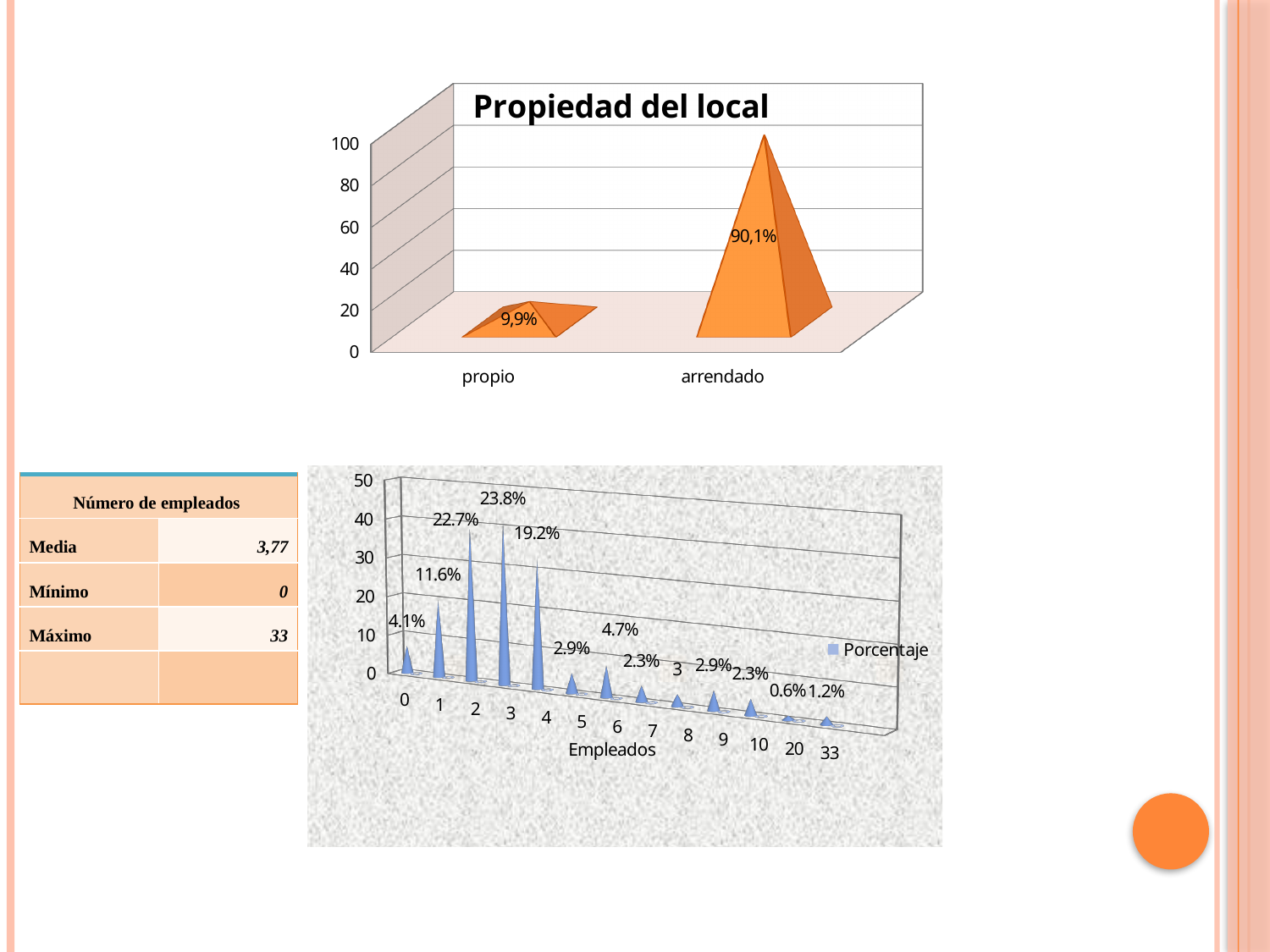
In the 'Propiedad del local' chart, what is the value for 'propio'? 9,9% In the bottom chart (Empleados), what is the value for 0 employees? 4.1% In the 'Propiedad del local' chart, how many categories are shown on the x axis? 2 In the bottom chart (Empleados), which number of employees has the lowest percentage? 20 In the bottom chart (Empleados), how many categories are shown on the x axis? 13 In the bottom chart (Empleados), what is the value for 3 employees? 23.8% In the bottom chart (Empleados), which is larger, the value for 1 employee or the value for 4 employees? 4 employees In the bottom chart (Empleados), what series name does the legend show? Porcentaje In the 'Propiedad del local' chart, what is the value for 'arrendado'? 90,1% In the bottom chart (Empleados), which number of employees has the highest percentage? 3 In the 'Propiedad del local' chart, is the value for 'arrendado' greater or less than 80? greater In the 'Propiedad del local' chart, which category has the highest value? arrendado